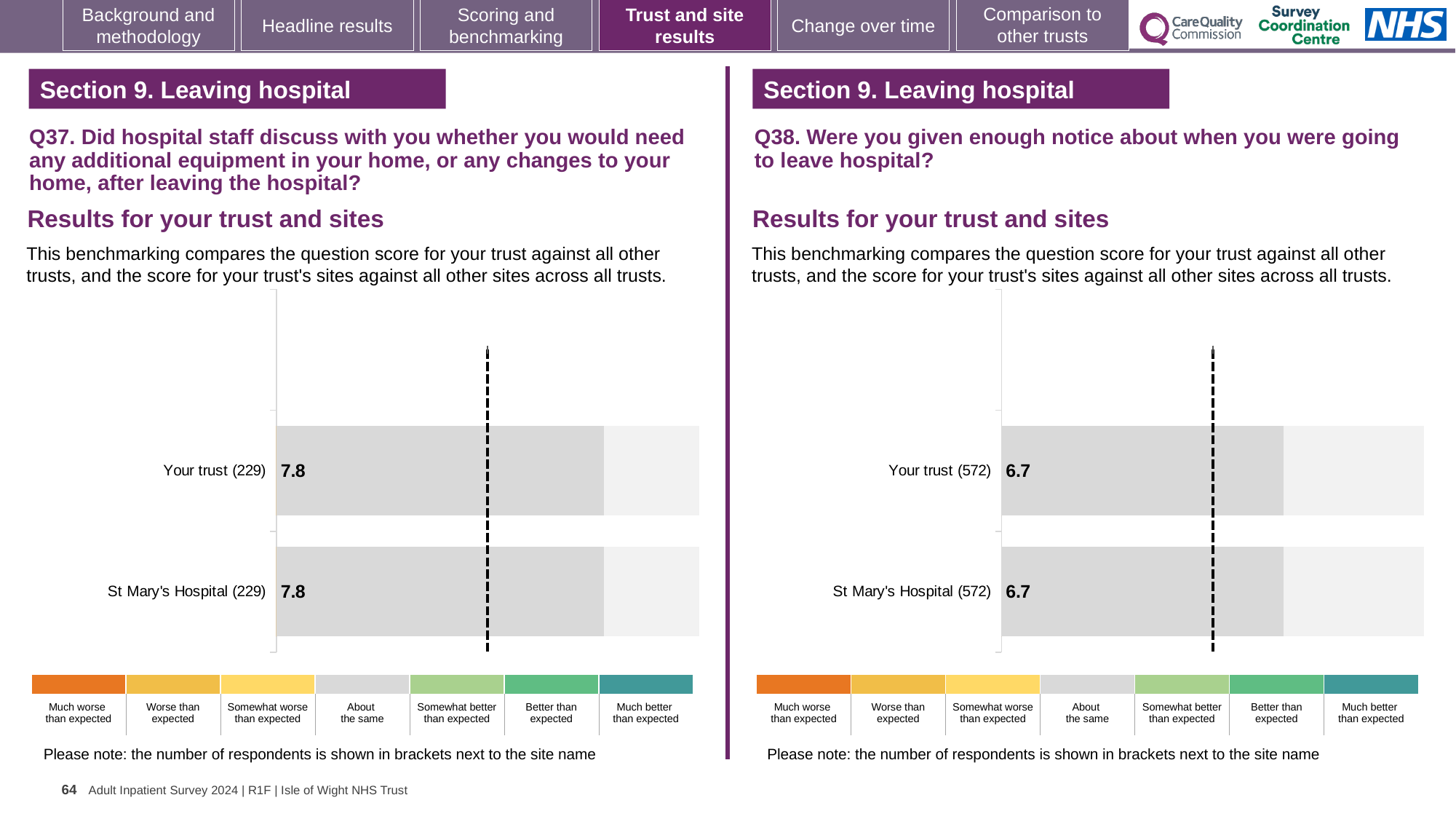
On the Q38 chart on the right, how many bars are plotted? 2 Is the score for Your trust on the Q37 chart on the left larger than the score for Your trust on the Q38 chart on the right? Yes On the Q37 chart on the left, what is the score for Your trust? 7.8 On the Q38 chart on the right, what is the score for Your trust? 6.7 On the Q37 chart on the left, what is the difference between the score for Your trust and the score for St Mary's Hospital? 0.0 On the Q38 chart on the right, how many respondents are shown in brackets for St Mary's Hospital? 572 How many categories does the colour legend below the Q37 chart on the left list? 7 On the Q38 chart on the right, which benchmark category does the colour of the bars correspond to in the legend? About the same On the Q37 chart on the left, how many respondents are shown in brackets for Your trust? 229 On the Q37 chart on the left, what is the score for St Mary's Hospital? 7.8 What kind of chart is the Q37 chart on the left? Bar chart On the Q38 chart on the right, what is the score for St Mary's Hospital? 6.7